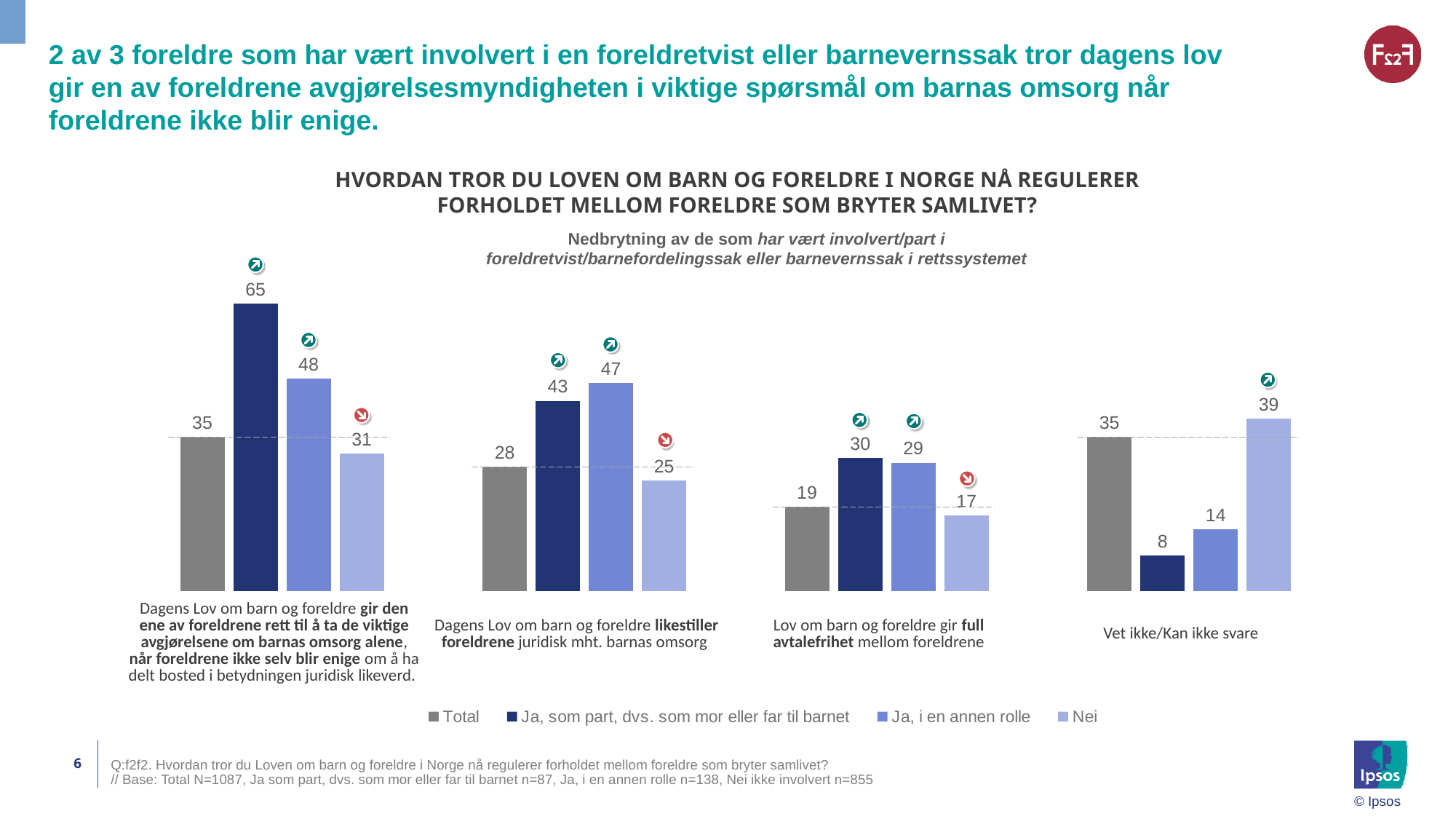
What is the value for "Ja, i en annen rolle" in the category "Dagens Lov om barn og foreldre likestiller foreldrene juridisk mht. barnas omsorg"? 47 Which category has the highest value for the "Ja, som part, dvs. som mor eller far til barnet" series? Dagens Lov om barn og foreldre gir den ene av foreldrene rett til å ta de viktige avgjørelsene om barnas omsorg alene What is the value for "Nei" in the category "Lov om barn og foreldre gir full avtalefrihet mellom foreldrene"? 17 How many series does the legend list? 4 What is the difference between the "Ja, som part" value and the Total value in the category "Dagens Lov om barn og foreldre gir den ene av foreldrene rett til å ta de viktige avgjørelsene om barnas omsorg alene"? 30 Which category has the lowest value for the "Ja, som part, dvs. som mor eller far til barnet" series? Vet ikke/Kan ikke svare What kind of chart is shown on the slide? Bar chart How many categories are shown on the x axis of the chart? 4 What is the value for "Ja, som part, dvs. som mor eller far til barnet" in the category "Dagens Lov om barn og foreldre gir den ene av foreldrene rett til å ta de viktige avgjørelsene om barnas omsorg alene"? 65 In the category "Vet ikke/Kan ikke svare", which is larger: the value for "Nei" or the value for "Ja, i en annen rolle"? Nei What is the difference between the "Nei" value and the "Ja, som part" value in the category "Vet ikke/Kan ikke svare"? 31 What is the Total value for the category "Vet ikke/Kan ikke svare"? 35